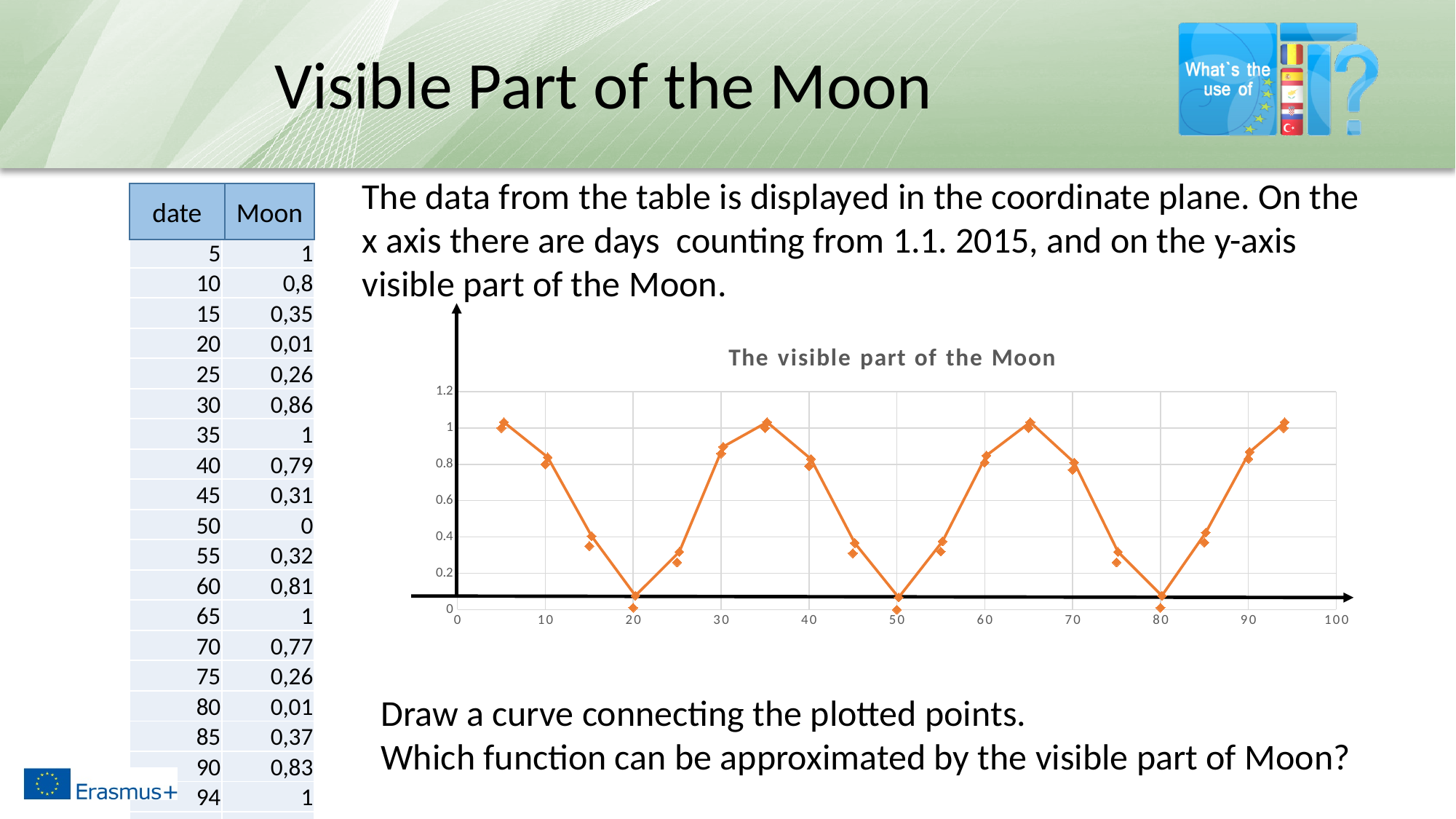
Do the plotted values rise or fall from day 20 to day 35? rise Is the value plotted for day 45 greater or less than 0.4? less What is the difference between the values for day 30 and day 25? 0,6 What is the visible part of the Moon plotted for day 20? 0,01 Do the plotted values rise or fall from day 5 to day 20? fall What is the visible part of the Moon plotted for day 50? 0 What kind of chart is shown on the slide? line chart What is the visible part of the Moon plotted for day 35? 1 Which is larger, the value for day 25 or the value for day 30? day 30 Is the value plotted for day 60 greater or less than 0.6? greater How many data points are plotted on the chart? 19 What is the title of the chart? The visible part of the Moon